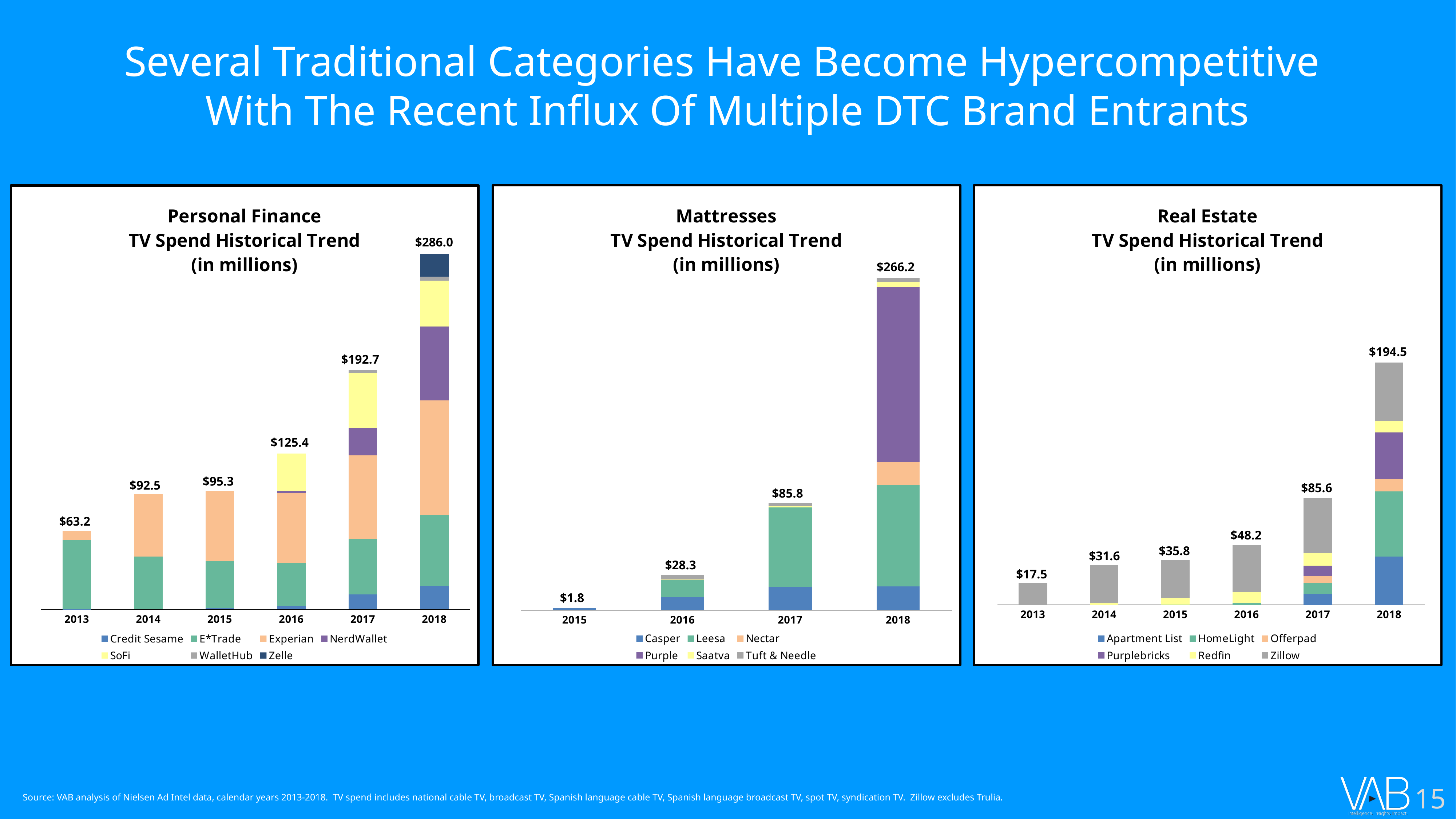
In the Personal Finance chart, what is the difference between the 2018 and 2017 totals? $93.3 In the Real Estate chart, which year has the lowest total TV spend? 2013 Which is larger: the 2018 total in the Personal Finance chart or the 2018 total in the Mattresses chart? Personal Finance ($286.0) How many years are shown in the Mattresses chart? 4 In the Real Estate chart, do the total values rise or fall from 2013 to 2018? Rise In the Mattresses chart, what is the total TV spend for 2015? $1.8 In the Mattresses chart, which year has the highest total TV spend? 2018 In the Personal Finance chart, what is the total TV spend for 2018? $286.0 In the Mattresses chart, how much larger is the 2018 total than the 2017 total? $180.4 In the Real Estate chart, what is the total TV spend for 2016? $48.2 What type of chart is the Real Estate TV Spend Historical Trend chart? Stacked bar chart How many brands does the legend of the Personal Finance chart list? 7